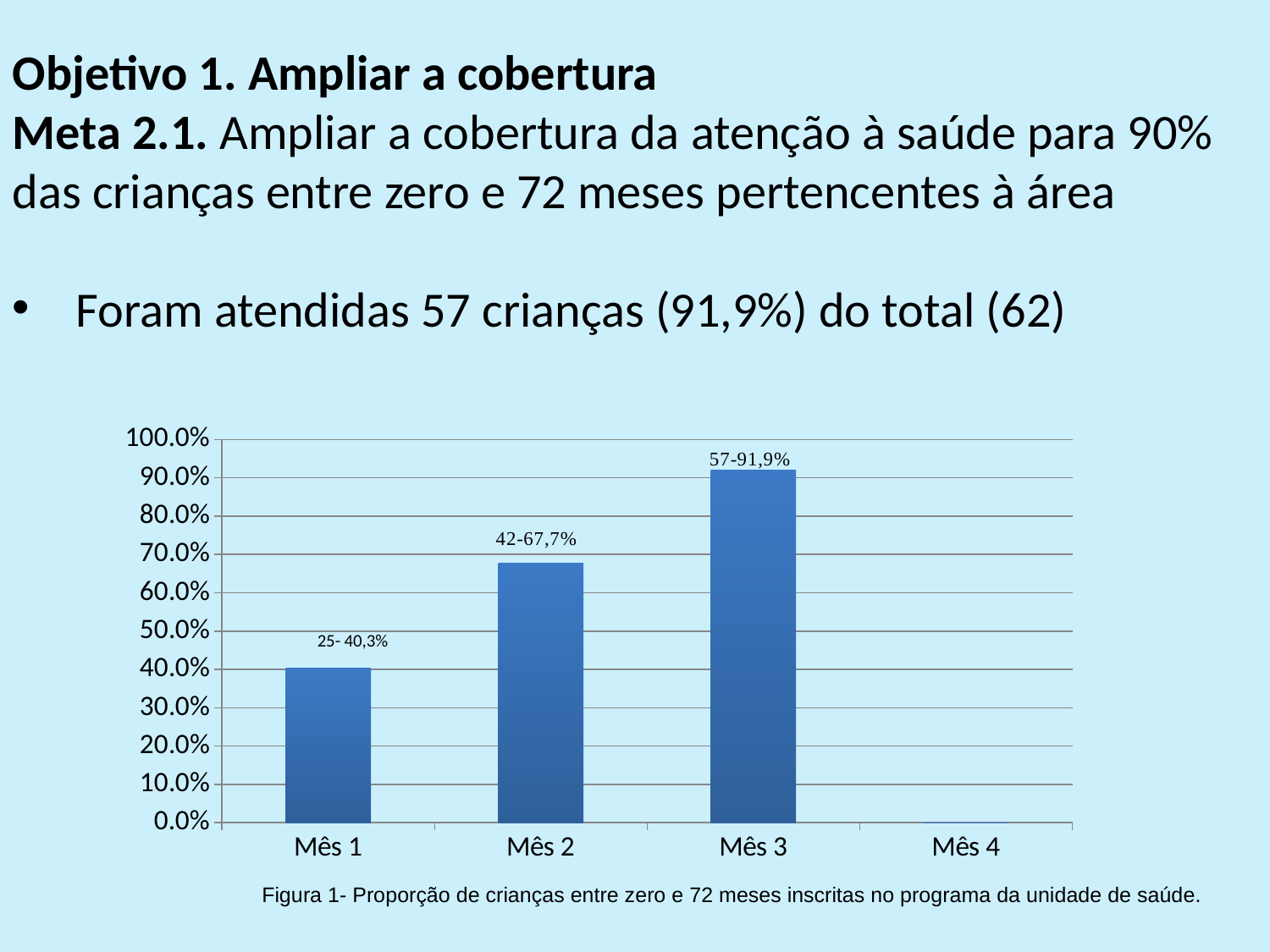
How many children does the data label for Mês 2 indicate? 42 What kind of chart is shown on the slide? bar chart What percentage is shown for Mês 1? 40,3% What is the difference in percentage points between Mês 3 and Mês 2? 24,2 What is the full data label printed above the Mês 2 bar? 42-67,7% Is the value for Mês 2 greater or less than 60.0%? greater Which month has the highest bar? Mês 3 Among Mês 1, Mês 2 and Mês 3, which has the lowest bar? Mês 1 What percentage is shown for Mês 3? 91,9% How many month categories are shown on the x axis? 4 How many more children were attended in Mês 3 than in Mês 1, according to the data labels? 32 Which is larger, the value for Mês 2 or the value for Mês 1? Mês 2